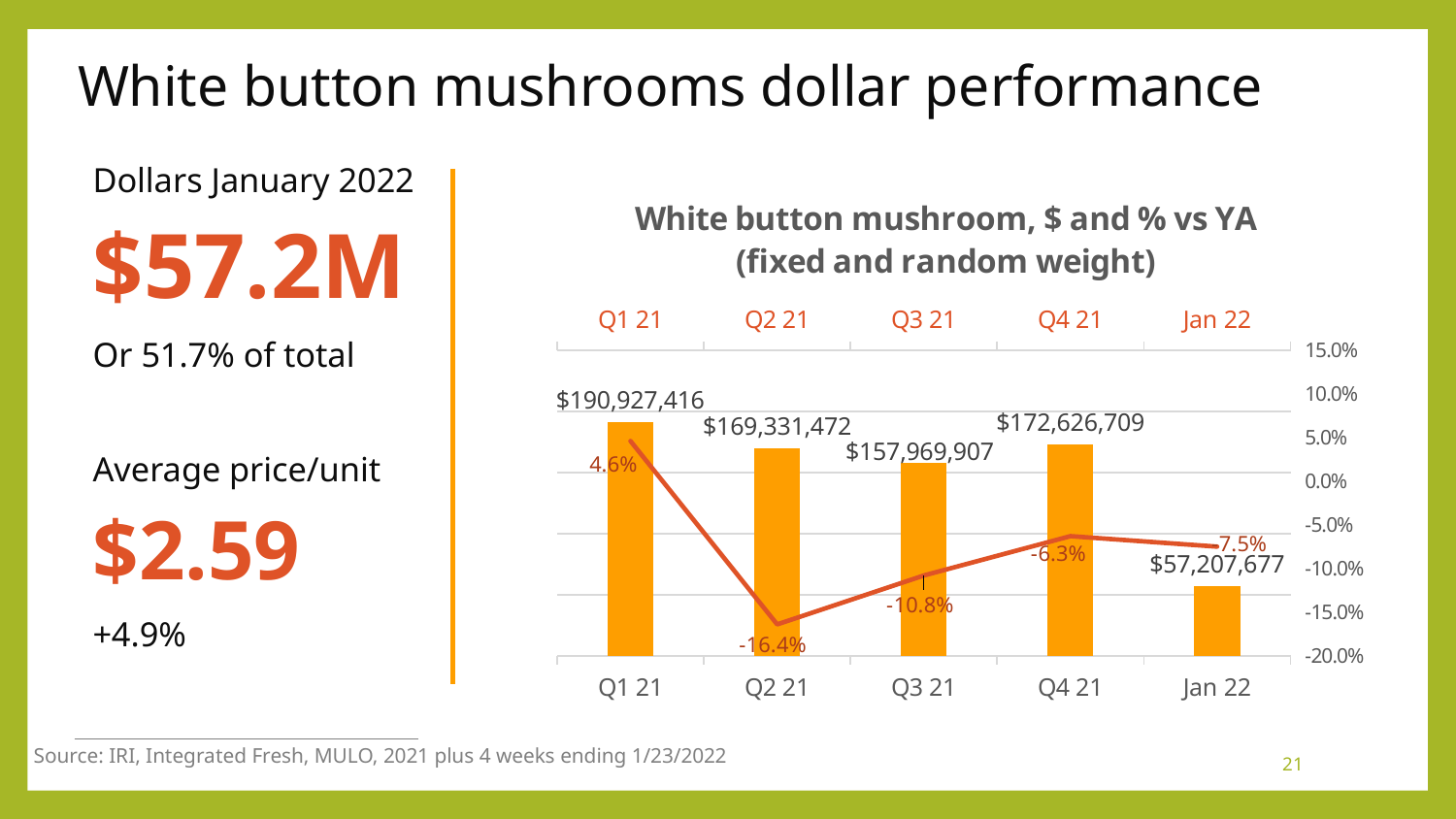
What is the % vs YA value for Q2 21? -16.4% What kind of chart is this? Combined bar and line chart What is the dollar value for Q1 21? $190,927,416 What is the % vs YA value for Q4 21? -6.3% How many periods are shown on the x axis? 5 What is the difference in dollar value between Q4 21 and Q3 21? $14,656,802 Which period has the lowest % vs YA value? Q2 21 Is the % vs YA value for Q3 21 greater or less than -5.0%? less What is the title of the chart? White button mushroom, $ and % vs YA (fixed and random weight) What is the dollar value for Jan 22? $57,207,677 Which period has the highest dollar value? Q1 21 Which has a larger dollar value, Q2 21 or Q4 21? Q4 21